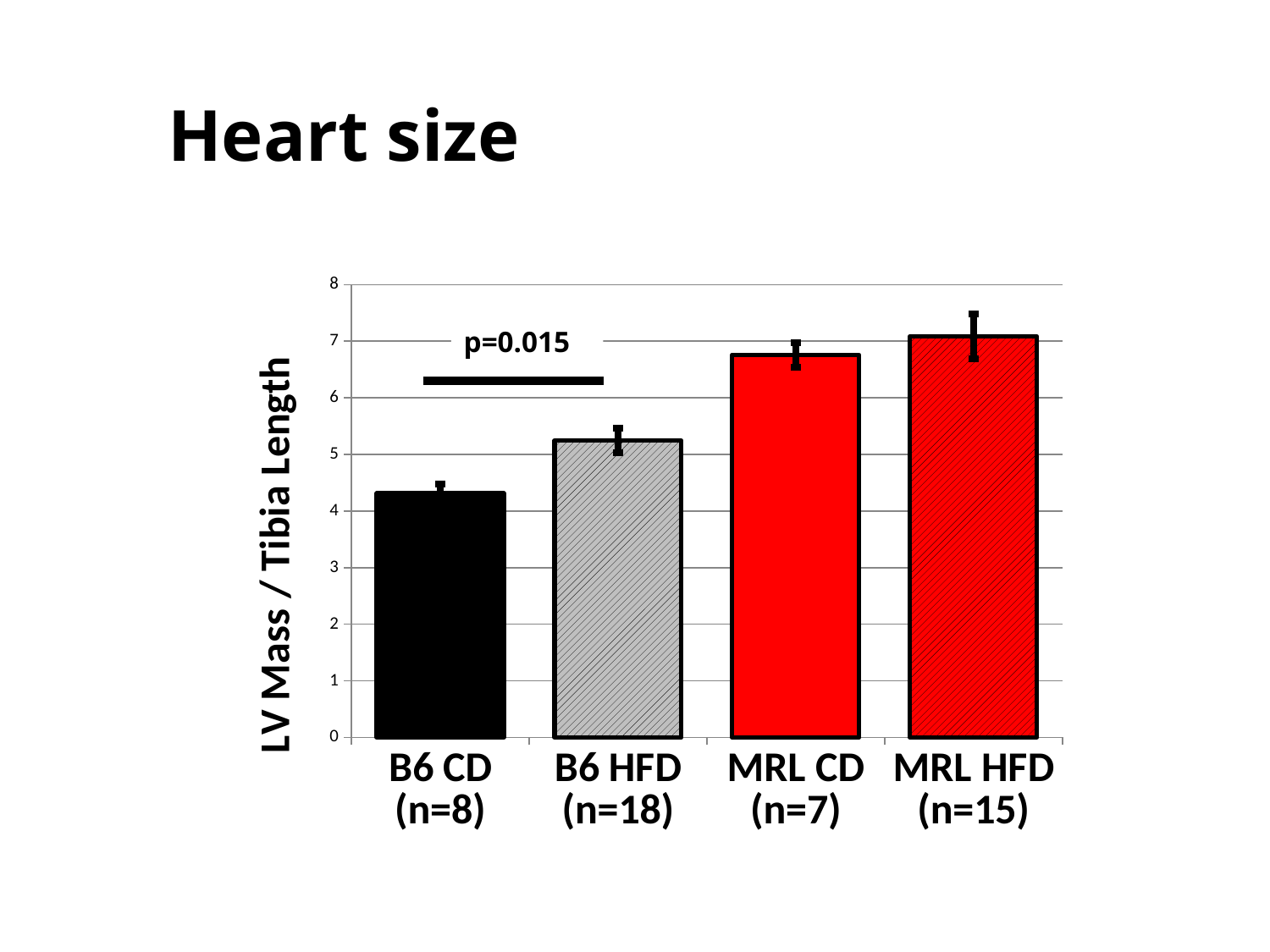
What is the label on the vertical axis of the chart? LV Mass / Tibia Length What kind of chart is shown on the slide? bar chart Which group has the lowest LV Mass / Tibia Length? B6 CD (n=8) How many bars (groups) are plotted in the chart? 4 Which group has the highest LV Mass / Tibia Length? MRL HFD (n=15) Is the value for MRL CD (n=7) greater or less than 7? less Is the value for B6 HFD (n=18) greater or less than 5? greater Is the value for B6 CD (n=8) greater or less than 5? less What p-value is shown above the bars for B6 CD and B6 HFD? p=0.015 Which is larger, the value for B6 HFD (n=18) or the value for MRL CD (n=7)? MRL CD (n=7) Do the bar values rise or fall from left to right across the x axis? rise